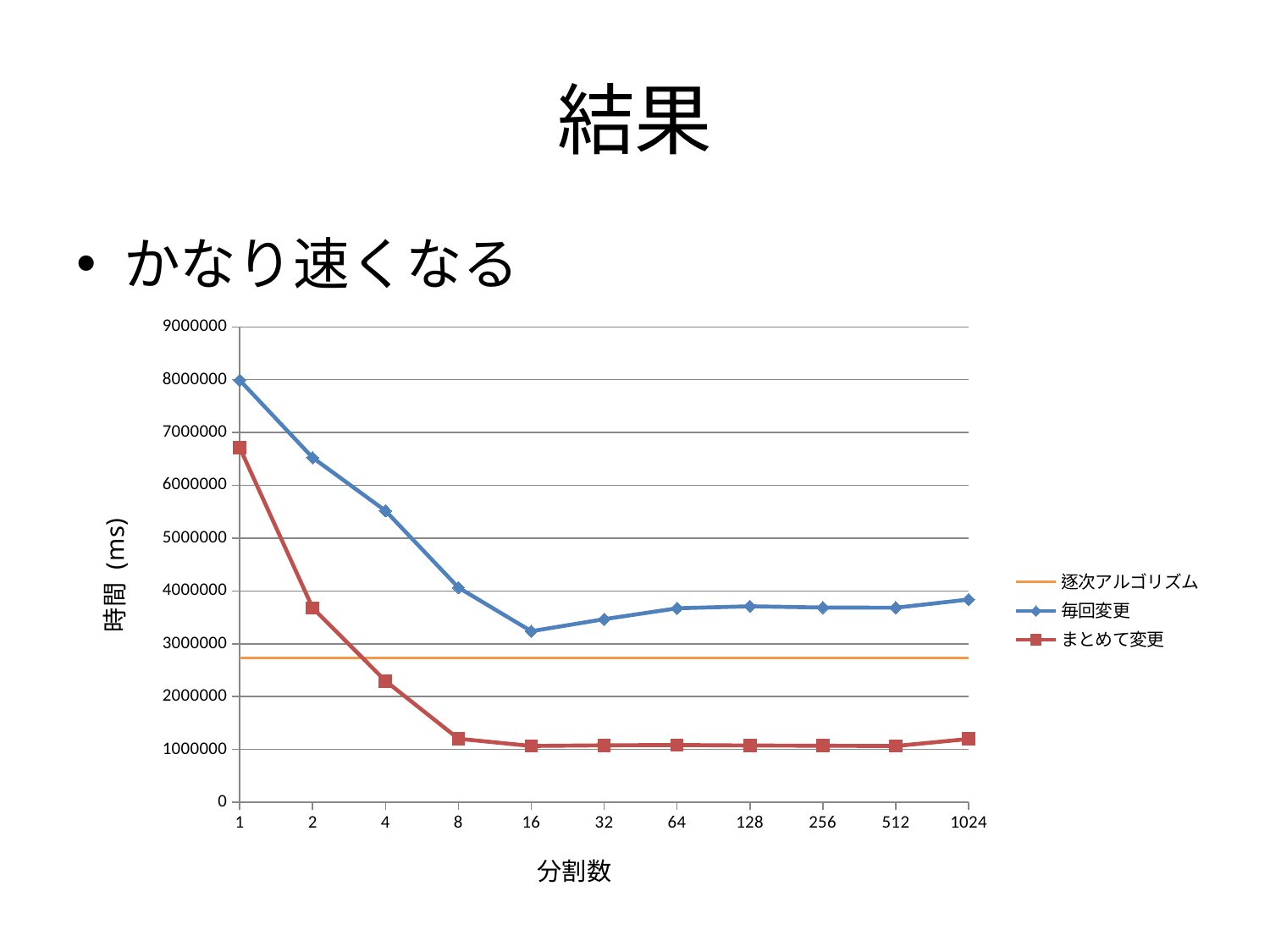
What is the label of the y axis? 時間 (ms) Is the value for 毎回変更 at 分割数 = 1 greater or less than 7000000? greater Does the まとめて変更 series rise or fall from 分割数 = 1 to 分割数 = 8? fall Is the value for 毎回変更 at 分割数 = 16 greater or less than 3000000? greater How many series does the legend list? 3 At 分割数 = 8, which series has the larger value, 毎回変更 or まとめて変更? 毎回変更 What kind of chart is shown on the slide? line chart How many categories are shown on the x axis (分割数)? 11 At which 分割数 does the 毎回変更 series reach its highest value? 1 What is the label of the x axis? 分割数 Is the value for まとめて変更 at 分割数 = 16 greater or less than 2000000? less